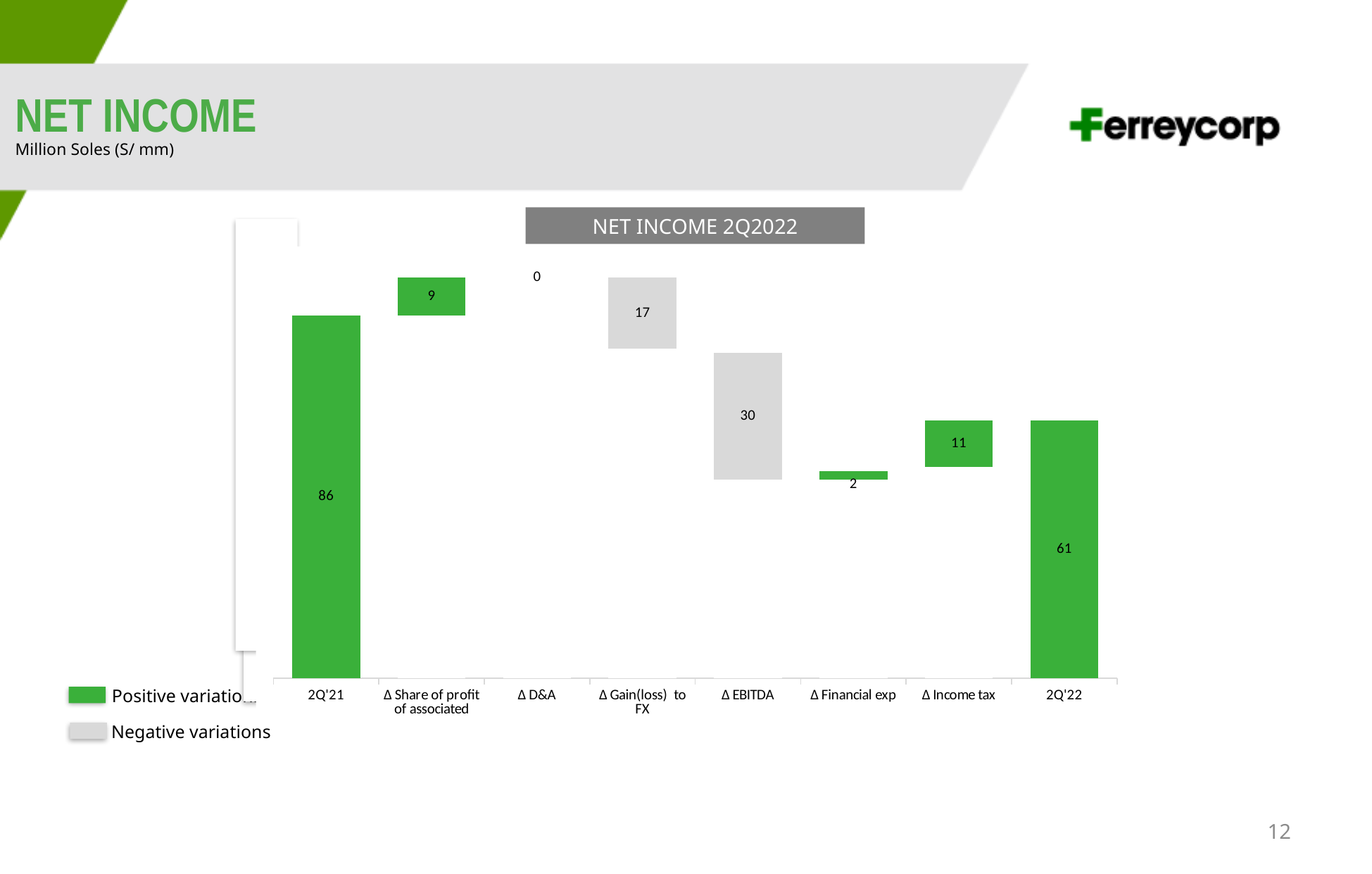
Which category has the largest value in the chart? 2Q'21 What value is shown for Δ Gain(loss) to FX? 17 How many categories are shown on the x axis of the chart? 8 What is the net income value shown for 2Q'22? 61 What value is shown for Δ D&A? 0 What value is shown for Δ EBITDA? 30 Which is larger, the value for Δ EBITDA or the value for Δ Gain(loss) to FX? Δ EBITDA What is the net income value shown for 2Q'21? 86 What is the title of the chart? NET INCOME 2Q2022 What is the difference between the net income for 2Q'21 and 2Q'22? 25 What value is shown for Δ Income tax? 11 According to the legend, what colour represents negative variations? Grey